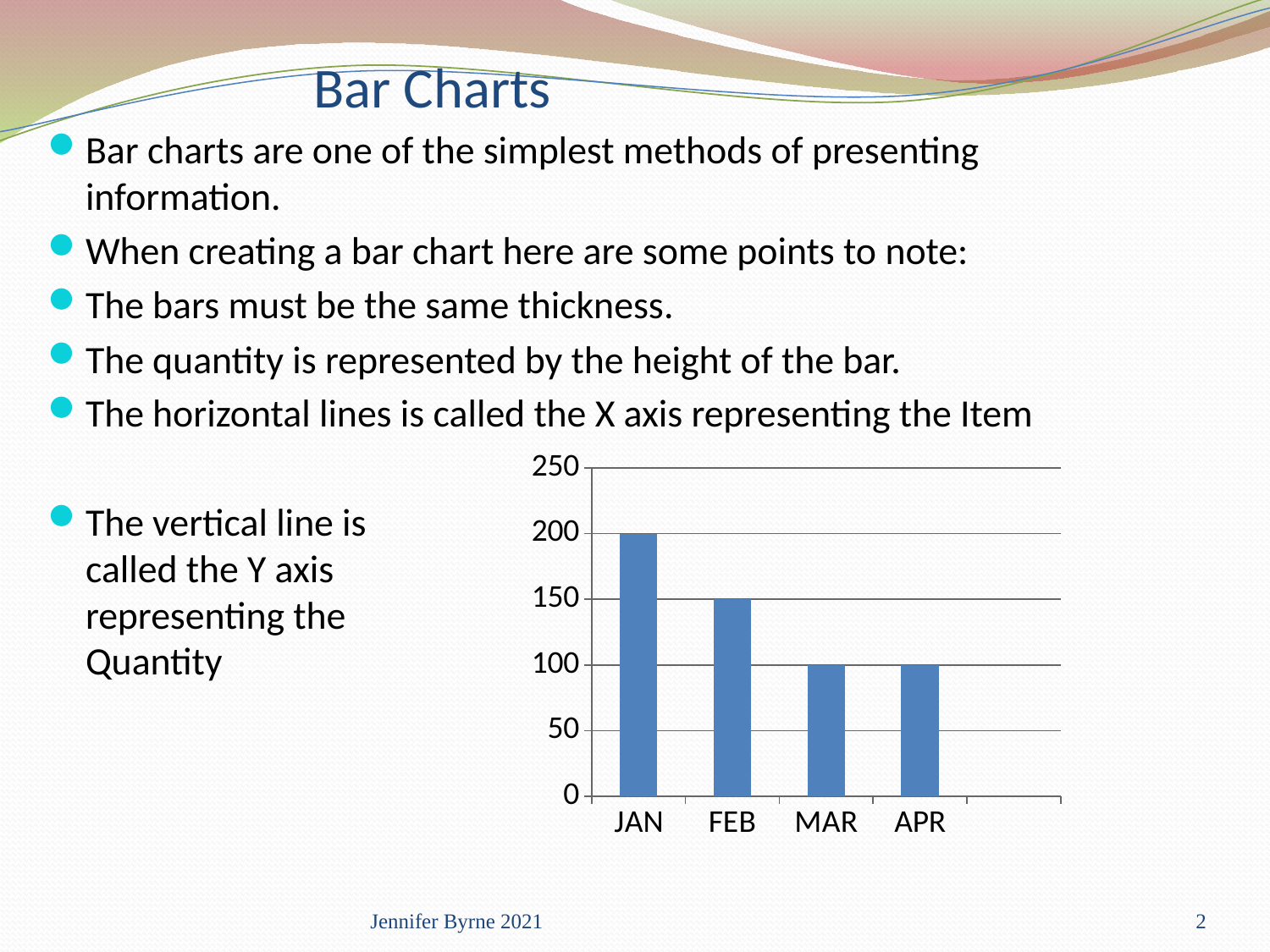
What is the difference between the values for JAN and MAR? 100 Do the bar values rise or fall from JAN to MAR along the x axis? fall What is the difference between the values for JAN and FEB? 50 Which month has the highest bar? JAN What kind of chart is shown on the slide? bar chart What is the value of the bar for JAN? 200 What is the highest value shown on the y axis of the chart? 250 What is the value of the bar for APR? 100 What is the value of the bar for MAR? 100 How many categories are shown on the x axis of the chart? 4 What is the value of the bar for FEB? 150 Which is larger, the value for FEB or the value for APR? FEB